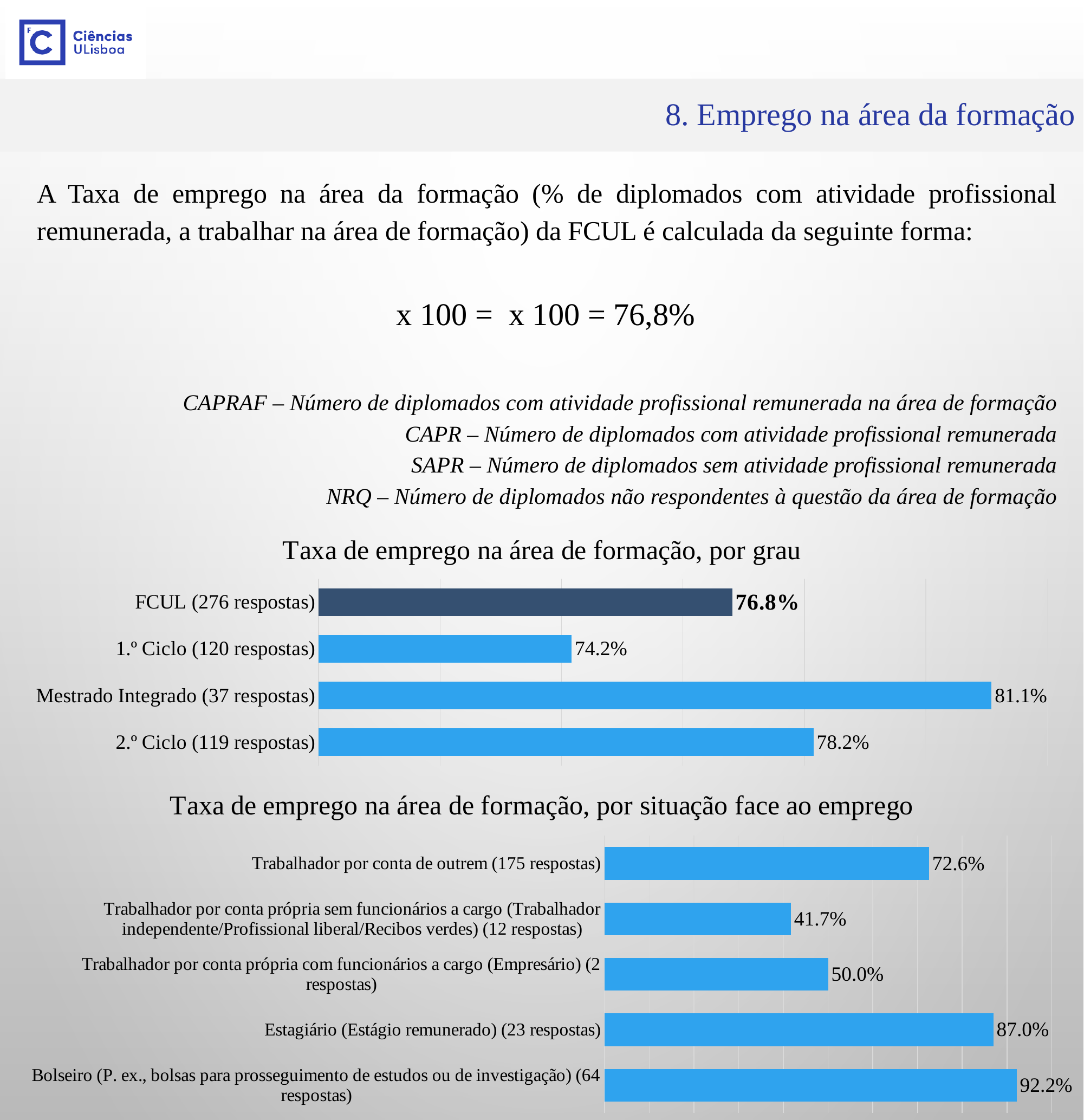
In the chart 'Taxa de emprego na área de formação, por grau', how many bars are shown? 4 In the chart 'Taxa de emprego na área de formação, por situação face ao emprego', which is larger: the value for Estagiário or the value for Trabalhador por conta de outrem? Estagiário What kind of chart is 'Taxa de emprego na área de formação, por situação face ao emprego'? Bar chart In the chart 'Taxa de emprego na área de formação, por situação face ao emprego', what is the value for Estagiário (Estágio remunerado) (23 respostas)? 87.0% In the chart 'Taxa de emprego na área de formação, por grau', what is the value for 1.º Ciclo (120 respostas)? 74.2% In the chart 'Taxa de emprego na área de formação, por grau', which category has the lowest value? 1.º Ciclo (120 respostas) In the chart 'Taxa de emprego na área de formação, por grau', what is the value for Mestrado Integrado (37 respostas)? 81.1% In the chart 'Taxa de emprego na área de formação, por situação face ao emprego', which category has the highest value? Bolseiro (P. ex., bolsas para prosseguimento de estudos ou de investigação) (64 respostas) In the chart 'Taxa de emprego na área de formação, por situação face ao emprego', what is the value for Trabalhador por conta de outrem (175 respostas)? 72.6% In the chart 'Taxa de emprego na área de formação, por grau', which category has the highest value? Mestrado Integrado (37 respostas) In the chart 'Taxa de emprego na área de formação, por situação face ao emprego', which category has the lowest value? Trabalhador por conta própria sem funcionários a cargo (Trabalhador independente/Profissional liberal/Recibos verdes) (12 respostas) In the chart 'Taxa de emprego na área de formação, por grau', what is the difference between the values for 2.º Ciclo and 1.º Ciclo? 4.0%